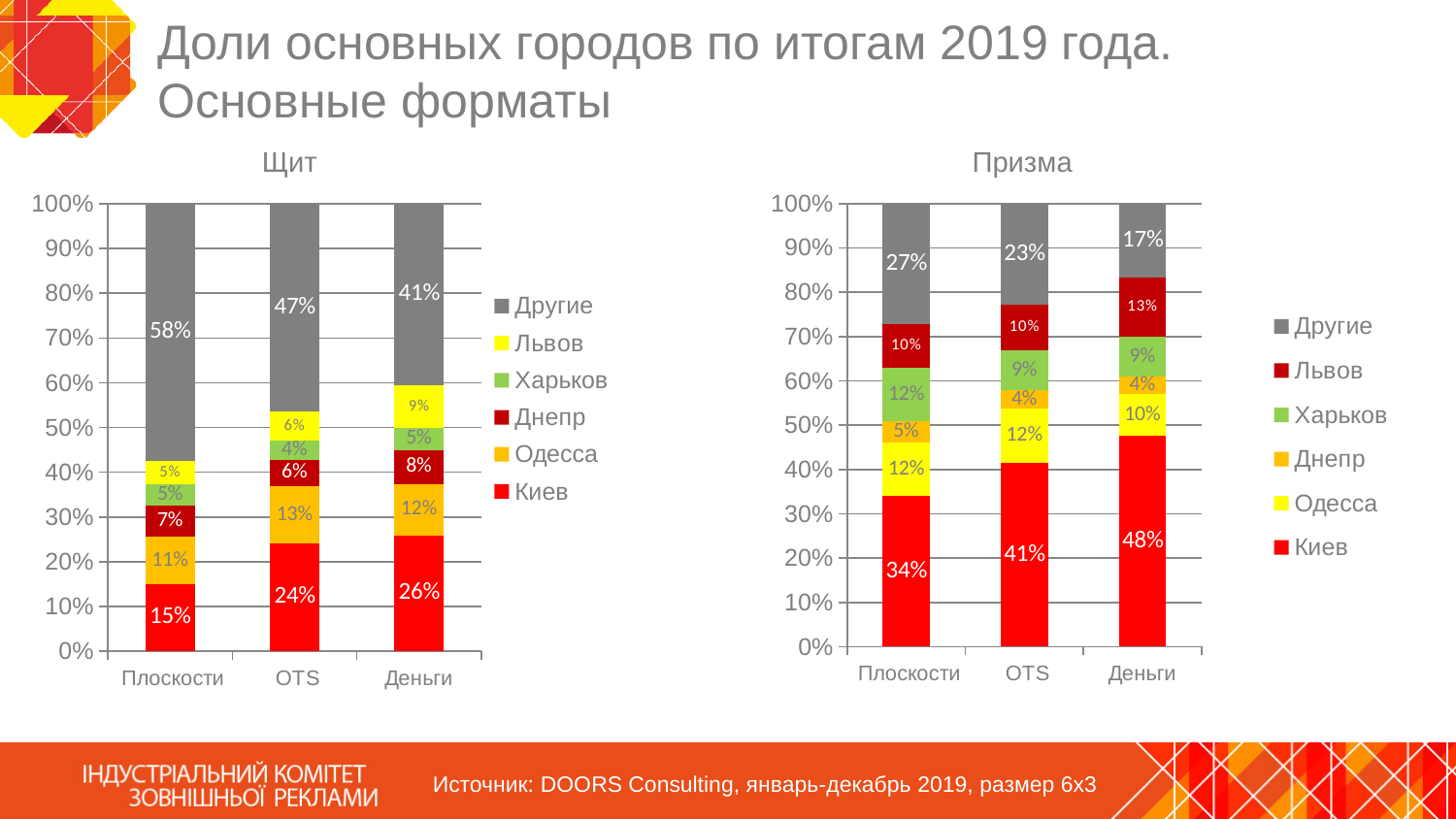
In the Щит chart, what is the value for Киев in the Плоскости category? 15% In the Призма chart, which category has the lowest value for Другие? Деньги How many categories are shown on the x axis of the Щит chart? 3 What type of chart is the Призма chart? Stacked bar chart In the Щит chart, what is the difference between the Другие values for Плоскости and OTS? 11% In the Призма chart, what is the value for Киев in the Деньги category? 48% In the Призма chart, what is the difference between the Киев values for Деньги and Плоскости? 14% How many series does the legend of the Призма chart list? 6 In the Щит chart, which category has the highest value for Киев? Деньги In the Щит chart, what is the value for Другие in the Деньги category? 41% Which is larger: the Киев value for OTS in the Щит chart or the Киев value for OTS in the Призма chart? Призма In the Призма chart, what is the value for Другие in the Плоскости category? 27%